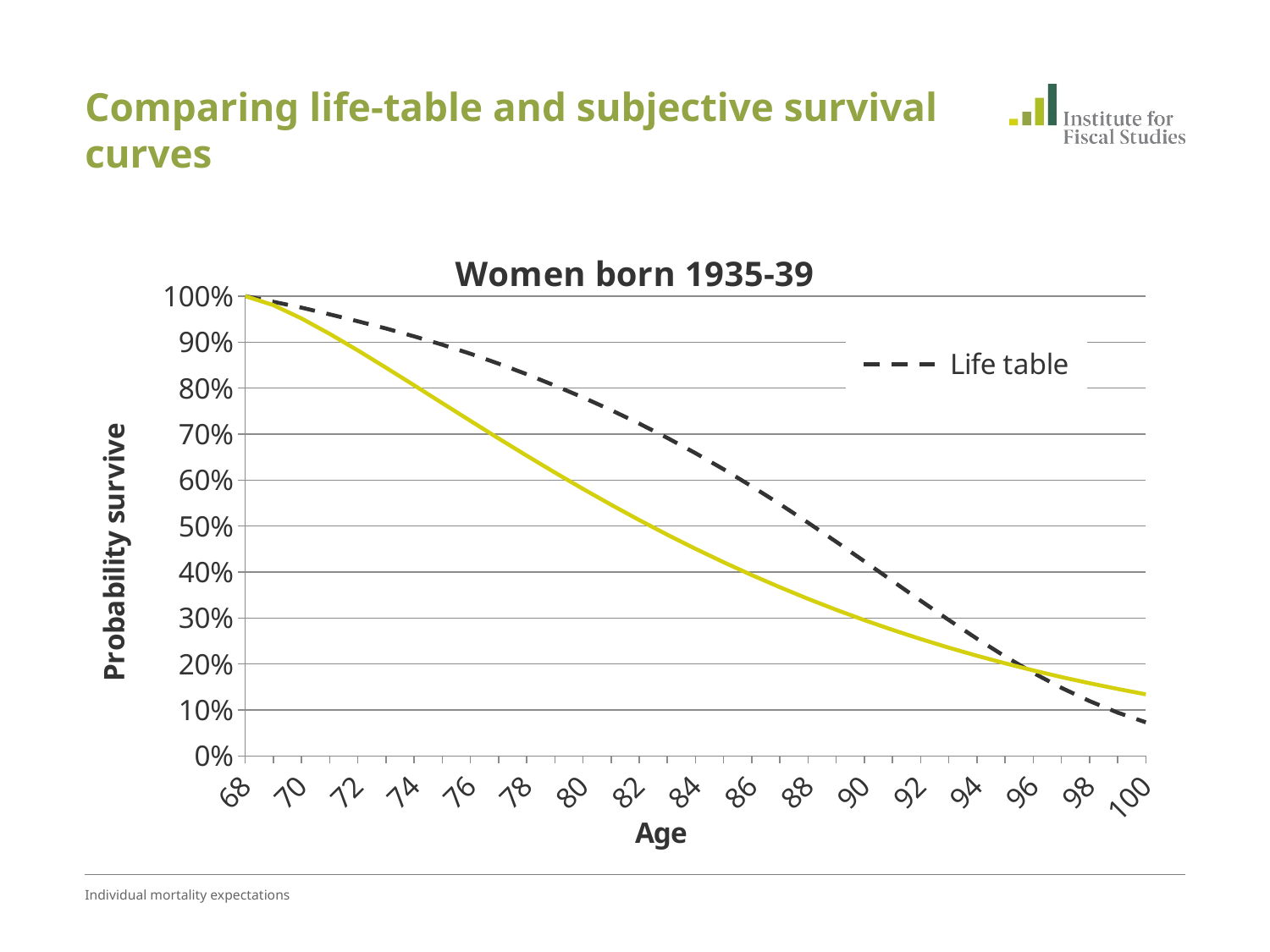
What is the title of the chart? Women born 1935-39 Is the Life table value at age 90 greater or less than 50%? less How many age labels are shown along the x axis? 17 What kind of chart is shown on the slide? line chart How many series does the chart's legend list? 1 Do the values of the Life table line rise or fall as age increases? fall At age 80, which line is higher: the dashed Life table line or the solid yellow-green line? Life table Is the Life table value at age 100 greater or less than 10%? less Is the Life table value at age 80 greater or less than 70%? greater What is the label on the vertical axis of the chart? Probability survive What is the Life table probability of survival at age 68? 100%